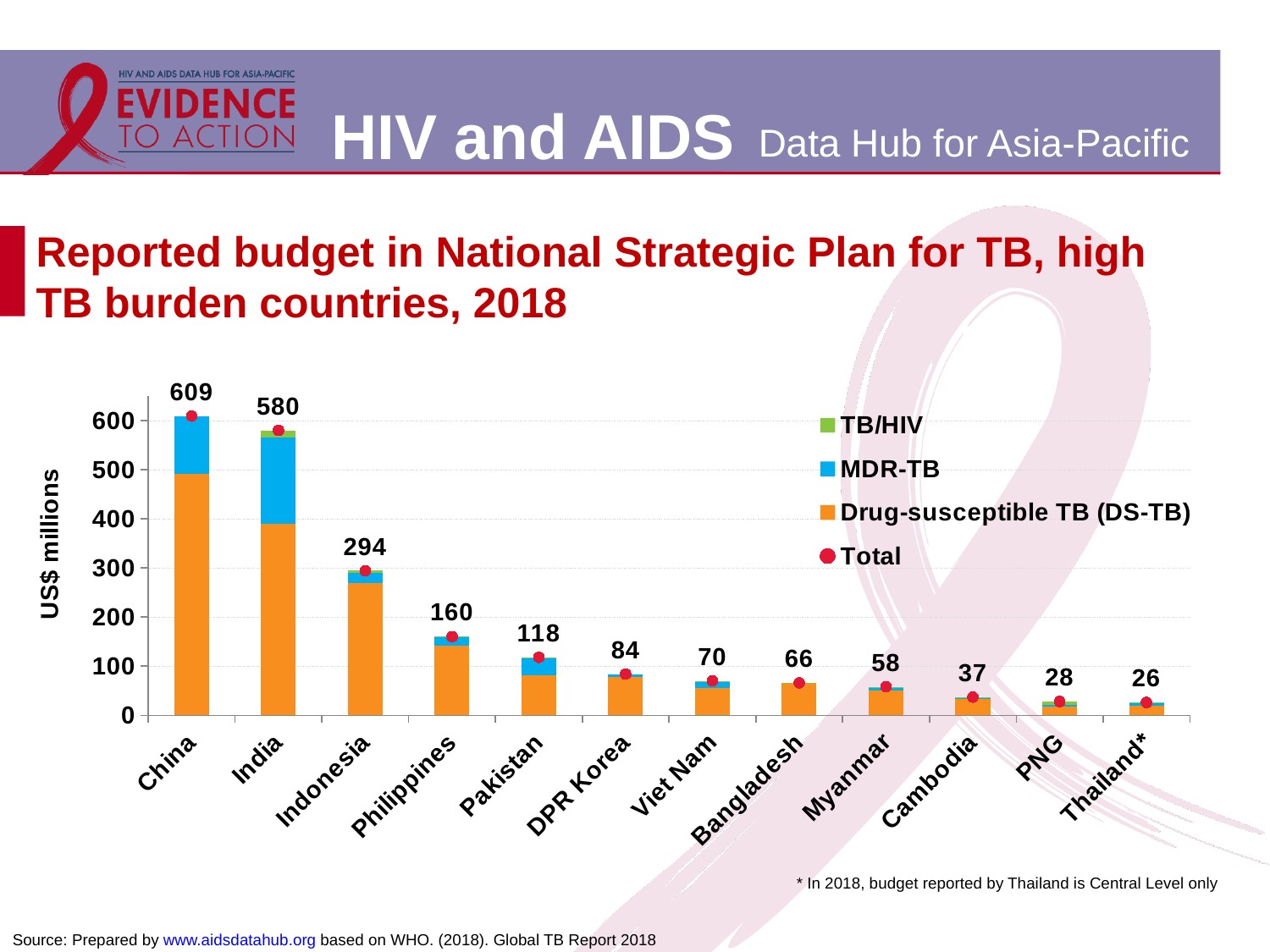
What is the unit shown on the y axis? US$ millions What is the total reported TB budget for Indonesia? 294 How many entries does the legend list? 4 What is the total reported TB budget for China? 609 Which country has the highest total reported TB budget? China Which has a larger total budget, Pakistan or DPR Korea? Pakistan How many countries are shown on the x axis? 12 What is the difference between the total budgets of China and India? 29 What kind of chart is shown? Stacked bar chart with total markers (combination bar and line chart) Which country has the lowest total reported TB budget? Thailand* Is the Drug-susceptible TB (DS-TB) value for India greater or less than 300? greater What is the total reported TB budget for Viet Nam? 70